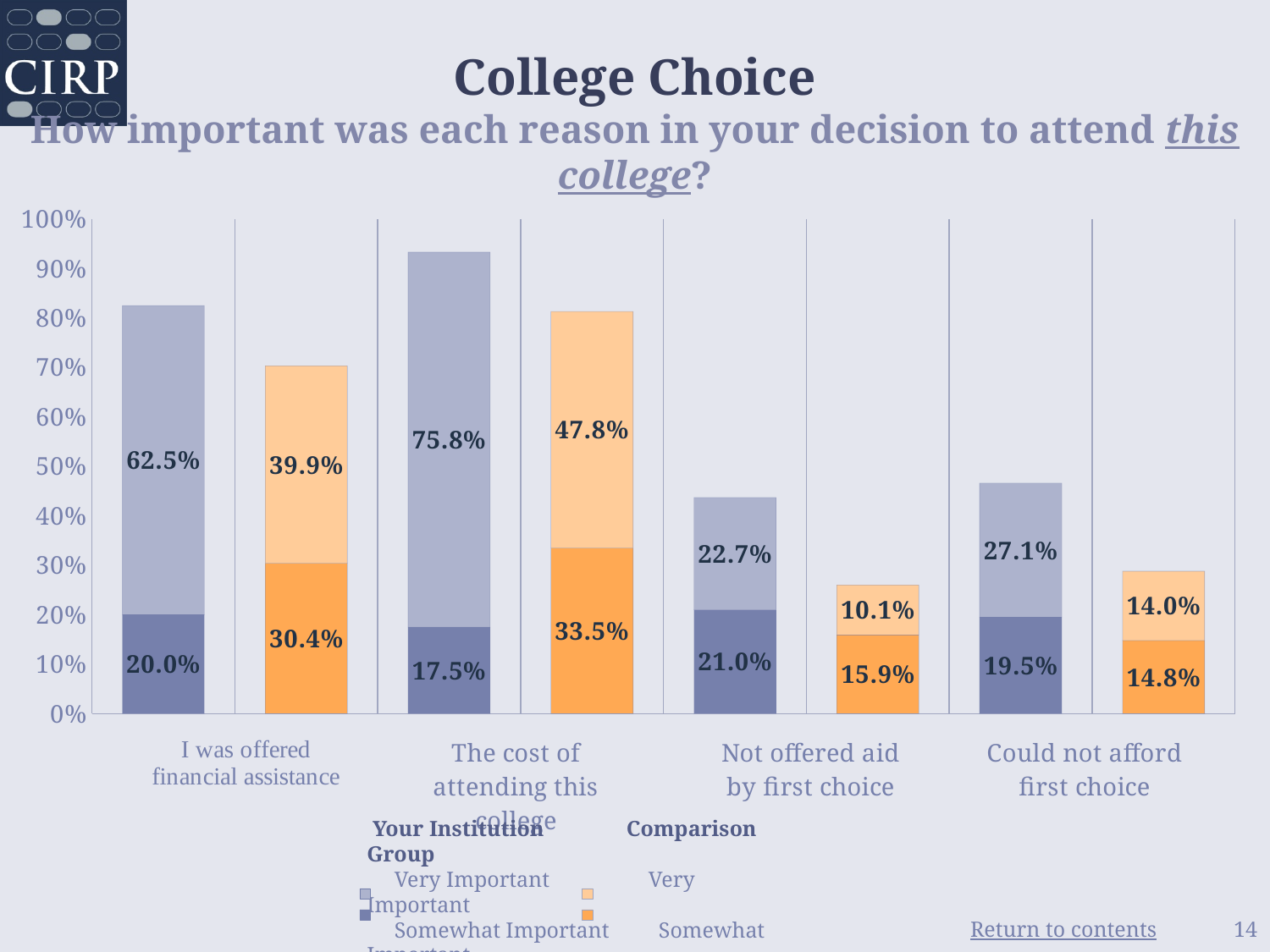
What is the total (Very Important plus Somewhat Important) for the Comparison Group on 'Not offered aid by first choice'? 26.0% What percentage of the Comparison Group rated 'I was offered financial assistance' as Somewhat Important? 30.4% Which reason has the highest Very Important percentage for Your Institution? The cost of attending this college Which reason has the lowest Very Important percentage for the Comparison Group? Not offered aid by first choice What is the total (Very Important plus Somewhat Important) for Your Institution on 'The cost of attending this college'? 93.3% How many reasons (categories) are shown on the x axis? 4 For 'Could not afford first choice', which is larger: the Very Important percentage for Your Institution or for the Comparison Group? Your Institution What is the difference between the Very Important percentages for Your Institution and the Comparison Group for 'I was offered financial assistance'? 22.6% What kind of chart is shown on the slide? Stacked bar chart What percentage of the Comparison Group rated 'Not offered aid by first choice' as Very Important? 10.1% How many series does the legend list? 4 What percentage of Your Institution respondents rated 'The cost of attending this college' as Very Important? 75.8%